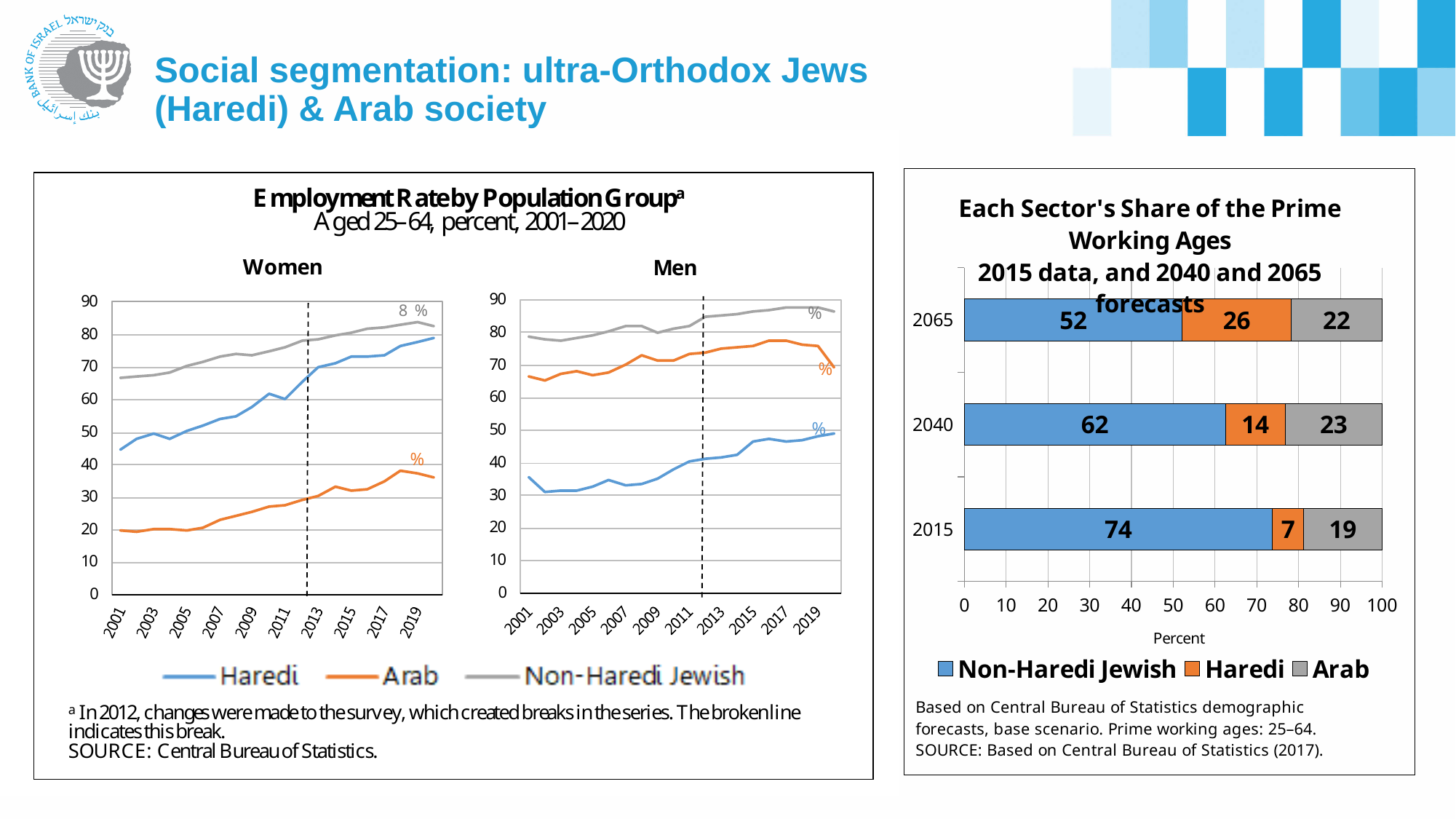
In the 'Each Sector's Share of the Prime Working Ages' chart, what is the Non-Haredi Jewish share in 2015? 74 In the 'Each Sector's Share of the Prime Working Ages' chart, is the Arab share larger in 2040 or in 2015? 2040 In the 'Each Sector's Share of the Prime Working Ages' chart, what is the Haredi share forecast for 2065? 26 In the 'Each Sector's Share of the Prime Working Ages' chart, by how much does the Haredi share in 2065 exceed the Haredi share in 2015? 19 In the 'Each Sector's Share of the Prime Working Ages' chart, what is the Arab share forecast for 2040? 23 In the Women panel of the 'Employment Rate by Population Group' chart, is the Haredi value in 2001 greater or less than 50? less What kind of chart is 'Each Sector's Share of the Prime Working Ages'? Stacked bar chart How many series does the legend of the 'Each Sector's Share of the Prime Working Ages' chart list? 3 In the 'Each Sector's Share of the Prime Working Ages' chart, which year has the lowest Non-Haredi Jewish share? 2065 In the 'Each Sector's Share of the Prime Working Ages' chart, what is the total of the three segments for the 2040 bar? 99 In the Men panel of the 'Employment Rate by Population Group' chart, is the Non-Haredi Jewish value in 2019 greater or less than 80? greater In the Women panel of the 'Employment Rate by Population Group' chart, does the Haredi employment rate generally rise or fall from 2001 to 2020? Rise